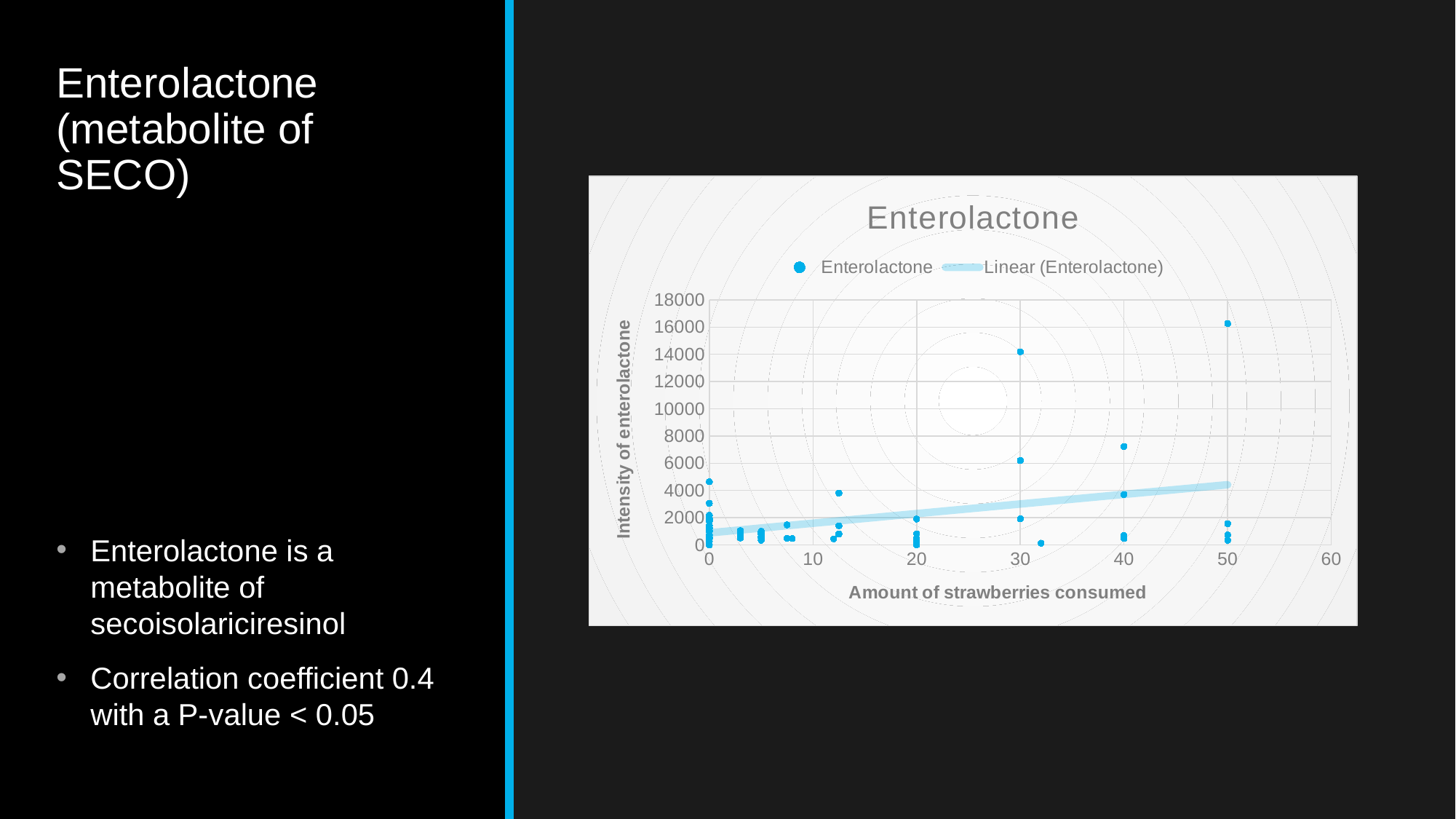
What is the title of the chart? Enterolactone Is the plotted point at about 32 strawberries consumed greater or less than 2000? less Does the linear trendline rise or fall as the amount of strawberries consumed increases? rises Is the highest plotted point at 30 strawberries consumed greater or less than 12000? greater Is the highest plotted point at 40 strawberries consumed greater or less than 6000? greater What kind of chart is shown on the slide? scatter chart How many entries does the chart legend list? 2 What is the label of the x axis of the chart? Amount of strawberries consumed Which has the higher maximum intensity of enterolactone: the points at 30 strawberries consumed or the points at 40 strawberries consumed? 30 strawberries consumed What is the highest value shown on the y axis of the chart? 18000 Which has the higher maximum intensity of enterolactone: the points at 50 strawberries consumed or the points at 30 strawberries consumed? 50 strawberries consumed